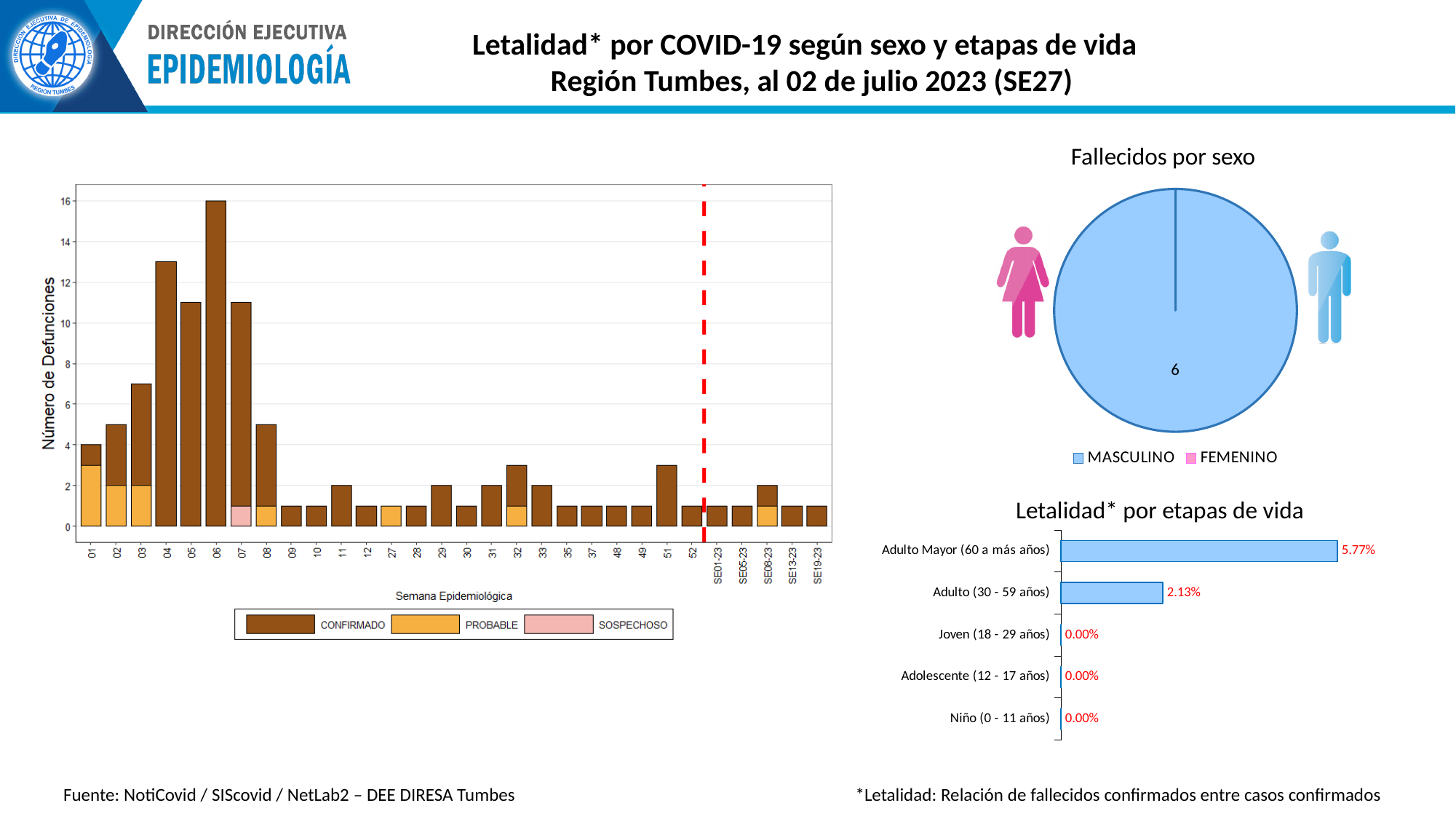
In the 'Número de Defunciones' chart on the left, what is the total number of deaths in week 06? 16 In the 'Letalidad* por etapas de vida' chart, what is the value for Adulto (30 - 59 años)? 2.13% In the 'Letalidad* por etapas de vida' chart, which age group has the highest value? Adulto Mayor (60 a más años) In the 'Letalidad* por etapas de vida' chart, what is the value for Adulto Mayor (60 a más años)? 5.77% In the 'Número de Defunciones' chart on the left, which epidemiological week has the highest number of deaths? 06 How many age groups are shown in the 'Letalidad* por etapas de vida' chart? 5 In the 'Fallecidos por sexo' chart, what value is shown for MASCULINO? 6 What kind of chart is 'Letalidad* por etapas de vida'? Bar chart How many series does the legend of the 'Fallecidos por sexo' chart list? 2 How many series does the legend of the 'Número de Defunciones' chart on the left list? 3 In the 'Letalidad* por etapas de vida' chart, what is the value for Joven (18 - 29 años)? 0.00% In the 'Letalidad* por etapas de vida' chart, what is the difference between the values for Adulto Mayor (60 a más años) and Adulto (30 - 59 años)? 3.64%